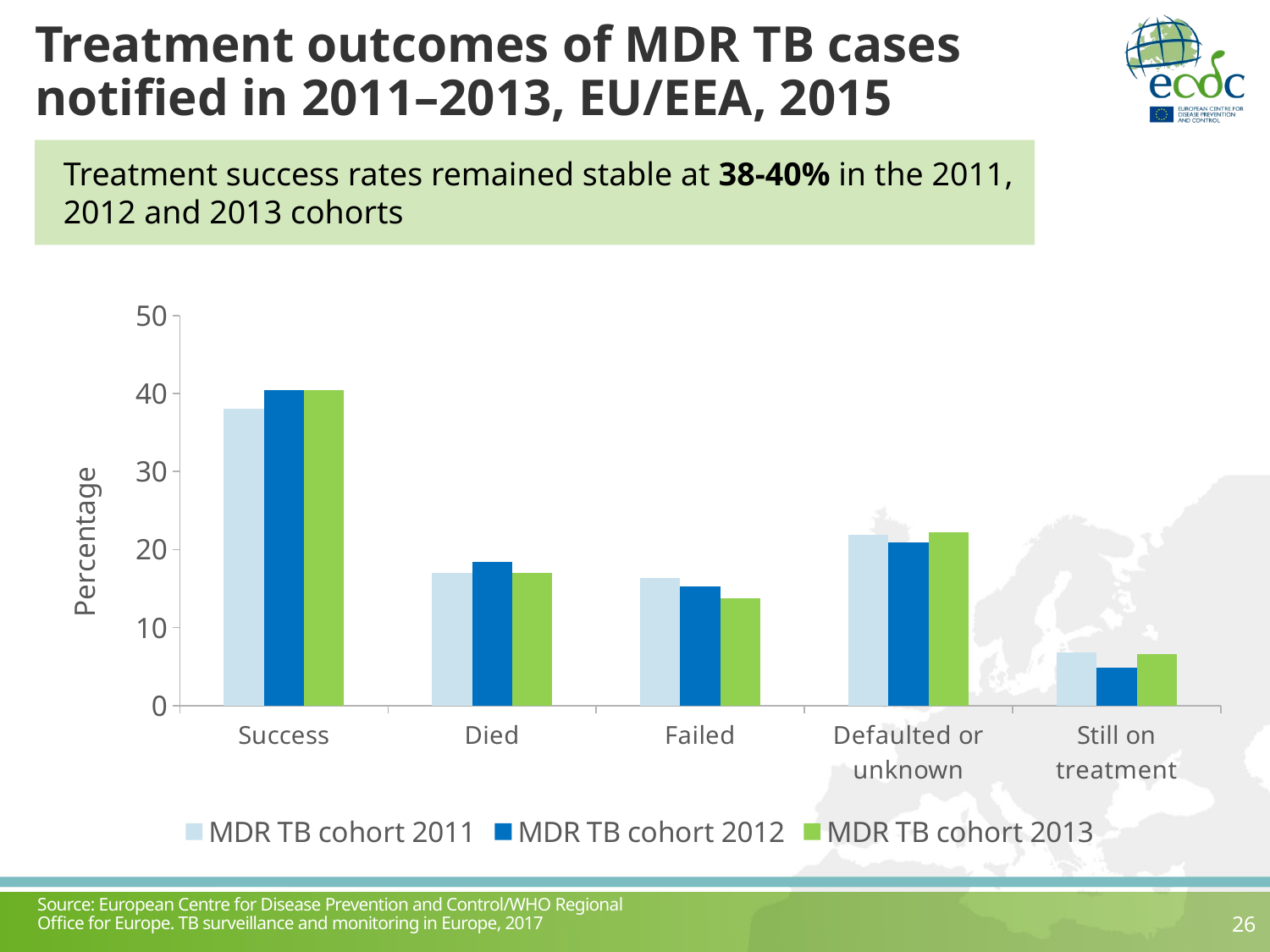
Is the value for Still on treatment in MDR TB cohort 2012 greater or less than 10? less Is the value for Defaulted or unknown in MDR TB cohort 2013 greater or less than 20? greater Which outcome category has the lowest value for MDR TB cohort 2012? Still on treatment How many series does the legend list? 3 For MDR TB cohort 2011, which is larger: the value for Defaulted or unknown or the value for Died? Defaulted or unknown Is the value for Died in MDR TB cohort 2012 greater or less than 20? less What kind of chart is shown on the slide? bar chart What is the label of the y axis? Percentage How many treatment outcome categories are shown on the x axis? 5 Which outcome category has the highest value for MDR TB cohort 2011? Success For MDR TB cohort 2013, which is larger: the value for Died or the value for Failed? Died